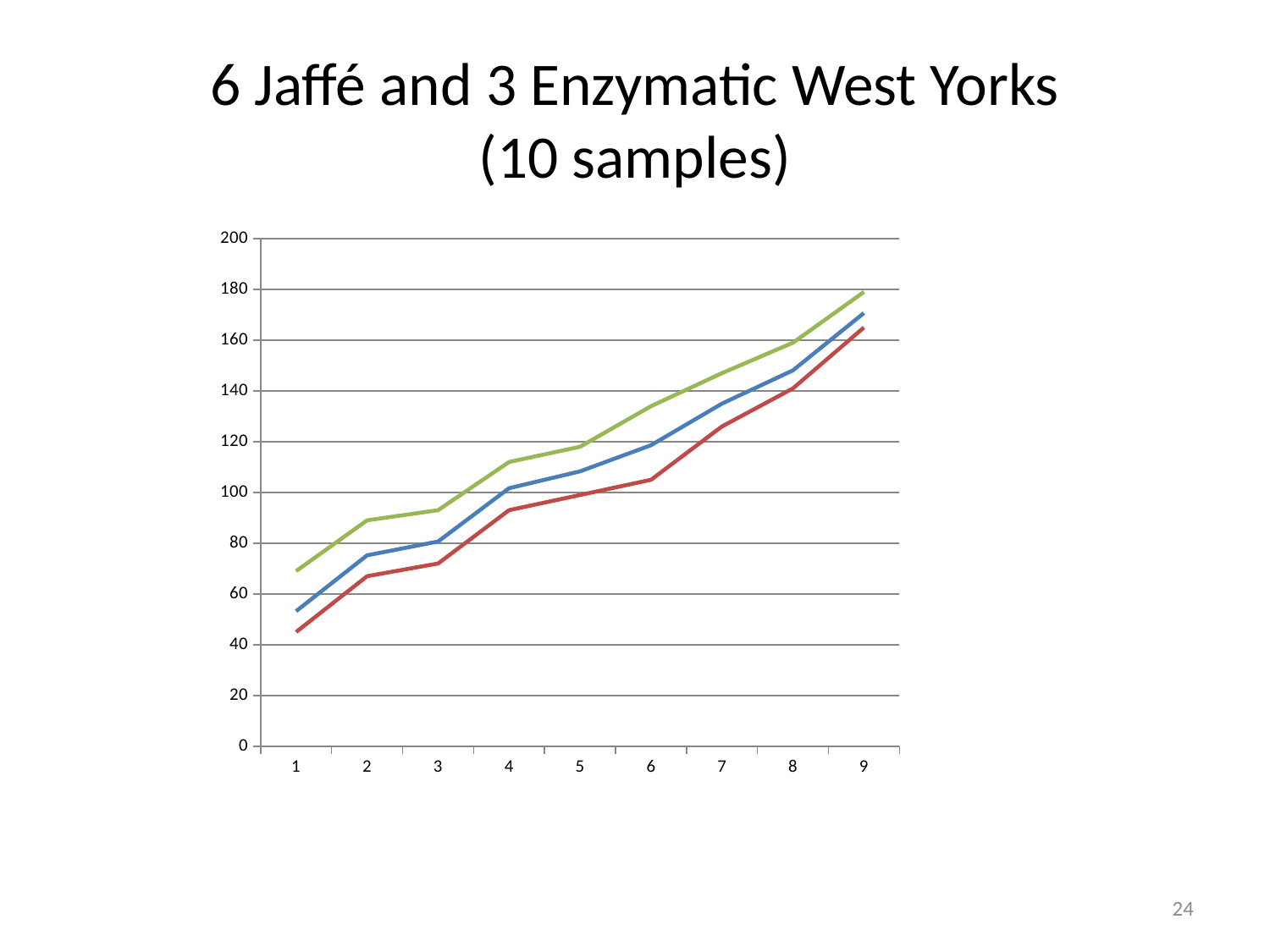
How many lines are plotted on the chart? 3 Is the value of the red line at x = 1 greater or less than 60? less Is the value of the green line at x = 9 greater or less than 160? greater What is the title of the slide? 6 Jaffé and 3 Enzymatic West Yorks (10 samples) How many points are plotted along the x axis? 9 At x = 9, which line is higher, the green line or the red line? green line What kind of chart is shown on the slide? line chart Do the values rise or fall from x = 1 to x = 9? rise Is the value of the red line at x = 4 greater or less than 100? less Which line has the highest value at x = 5? green line